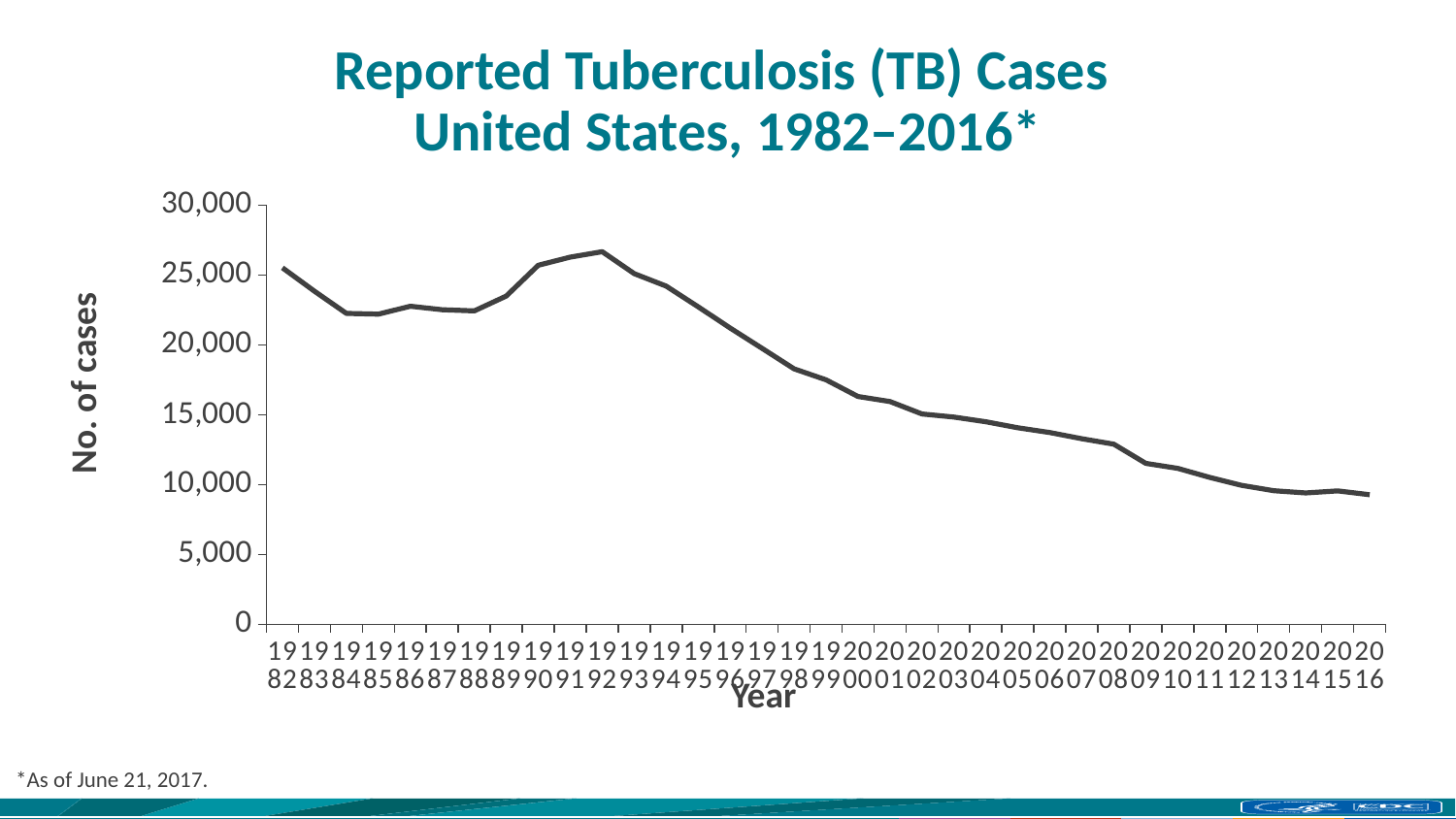
How many years (data points) are plotted on the chart? 35 What is the title of the chart? Reported Tuberculosis (TB) Cases United States, 1982–2016* Is the value for 2008 greater or less than 15,000? less Is the value for 1985 greater or less than 25,000? less Overall, do the reported TB cases rise or fall from 1982 to 2016? fall In which year does the number of reported TB cases reach its highest point? 1992 Is the value for 2016 greater or less than 10,000? less Which year has more reported TB cases, 1982 or 2000? 1982 What is the label on the y axis of the chart? No. of cases What kind of chart is shown on the slide? line chart